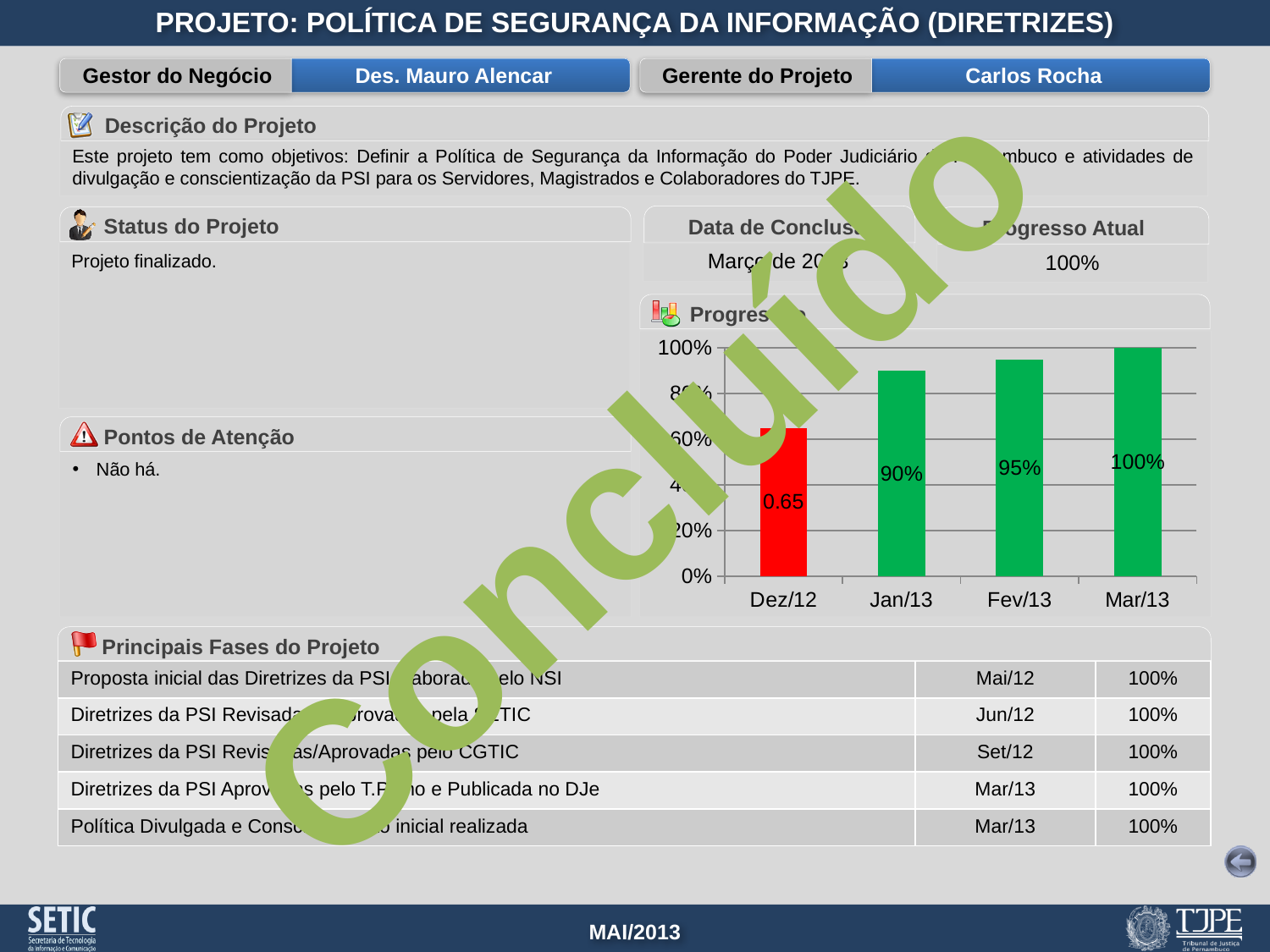
Do the values in the progress chart rise or fall from Dez/12 to Mar/13? rise Which month has the highest bar in the progress chart? Mar/13 What is the difference between the labelled values for Fev/13 and Jan/13 in the progress chart? 5% In the progress chart, which is larger: the value for Jan/13 or the value for Fev/13? Fev/13 Is the value for Dez/12 in the progress chart greater or less than 80%? less Which month has the lowest bar in the progress chart? Dez/12 What value is labelled on the bar for Fev/13 in the progress chart? 95% How many months are shown on the x axis of the progress chart? 4 What value is labelled on the bar for Dez/12 in the progress chart? 0.65 What is the difference between the labelled values for Mar/13 and Jan/13 in the progress chart? 10% What value is labelled on the bar for Mar/13 in the progress chart? 100% What value is labelled on the bar for Jan/13 in the progress chart? 90%